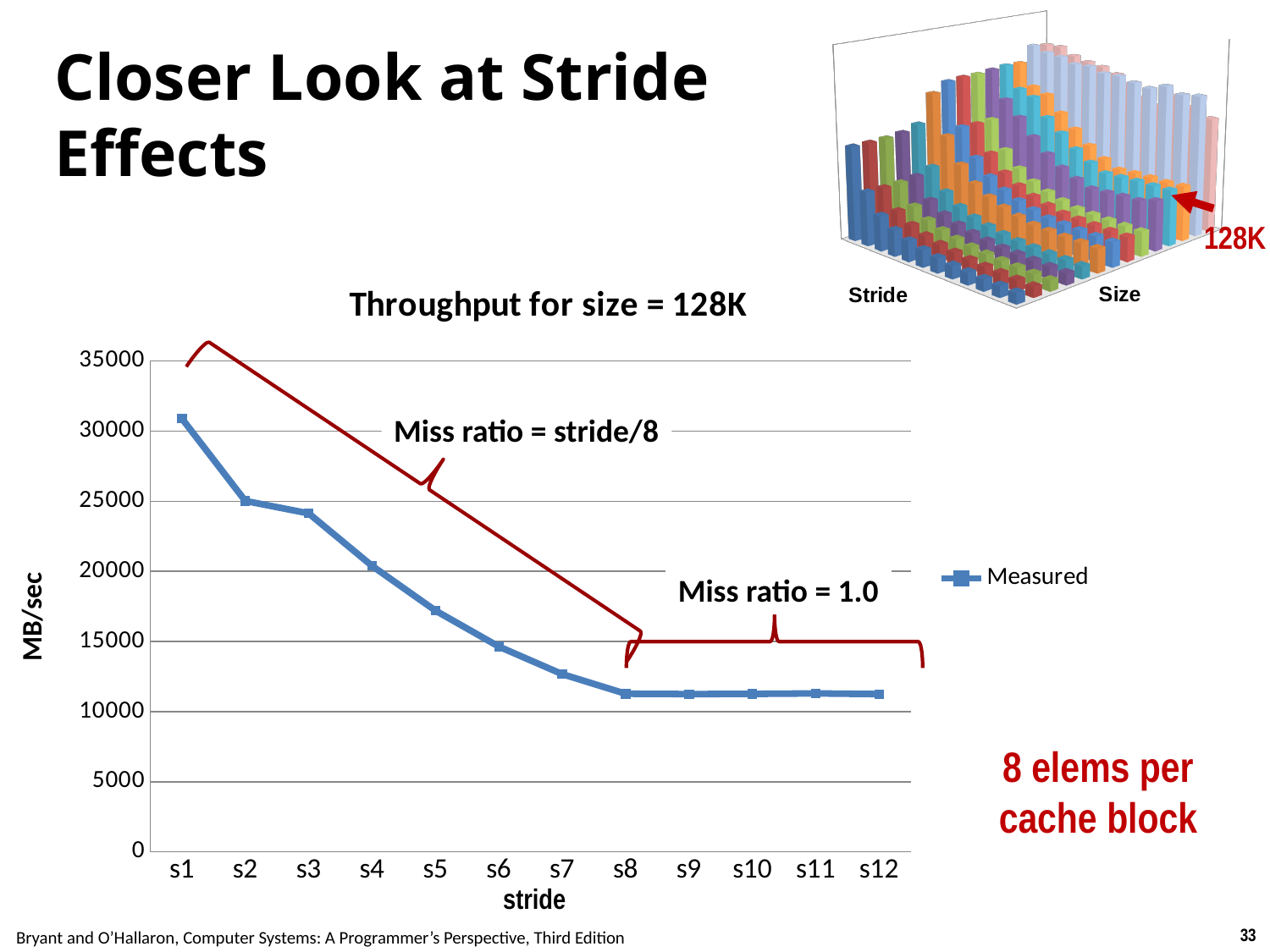
In the chart titled "Throughput for size = 128K", is the value for s8 greater or less than 15000? less In the chart titled "Throughput for size = 128K", is the value for s12 greater or less than 10000? greater In the chart titled "Throughput for size = 128K", what kind of chart is it? line chart In the chart titled "Throughput for size = 128K", is the value for s5 greater or less than 20000? less In the chart titled "Throughput for size = 128K", how many stride values are plotted along the x axis? 12 In the chart titled "Throughput for size = 128K", what is the name of the series shown in the legend? Measured In the chart titled "Throughput for size = 128K", which stride has the highest throughput? s1 In the chart titled "Throughput for size = 128K", which has the larger throughput, s2 or s7? s2 In the chart titled "Throughput for size = 128K", do the values rise or fall as the stride increases from s1 to s8? fall In the chart titled "Throughput for size = 128K", how many series does the legend list? 1 In the chart titled "Throughput for size = 128K", what is the label on the y axis? MB/sec